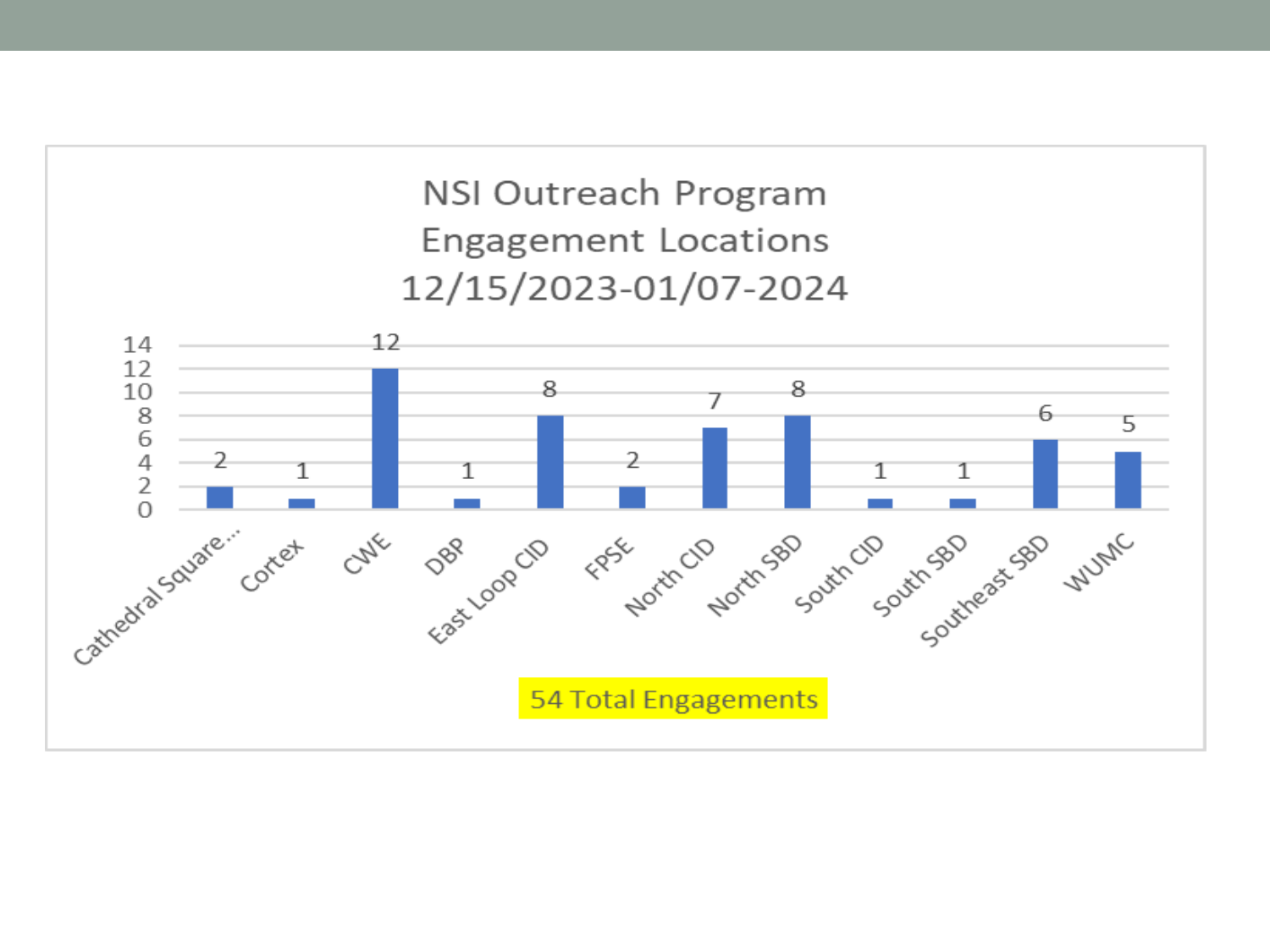
What is the value for CWE? 12 What date range appears in the chart title? 12/15/2023-01/07-2024 What is the difference between the values for CWE and East Loop CID? 4 What is the total number of engagements stated on the slide? 54 Total Engagements Which is larger, the value for North CID or the value for Southeast SBD? North CID How many locations are shown on the x axis? 12 What is the difference between the values for North SBD and WUMC? 3 What is the value for WUMC? 5 What is the value for Southeast SBD? 6 What kind of chart is shown on the slide? bar chart What is the value for North CID? 7 Which location has the highest value? CWE